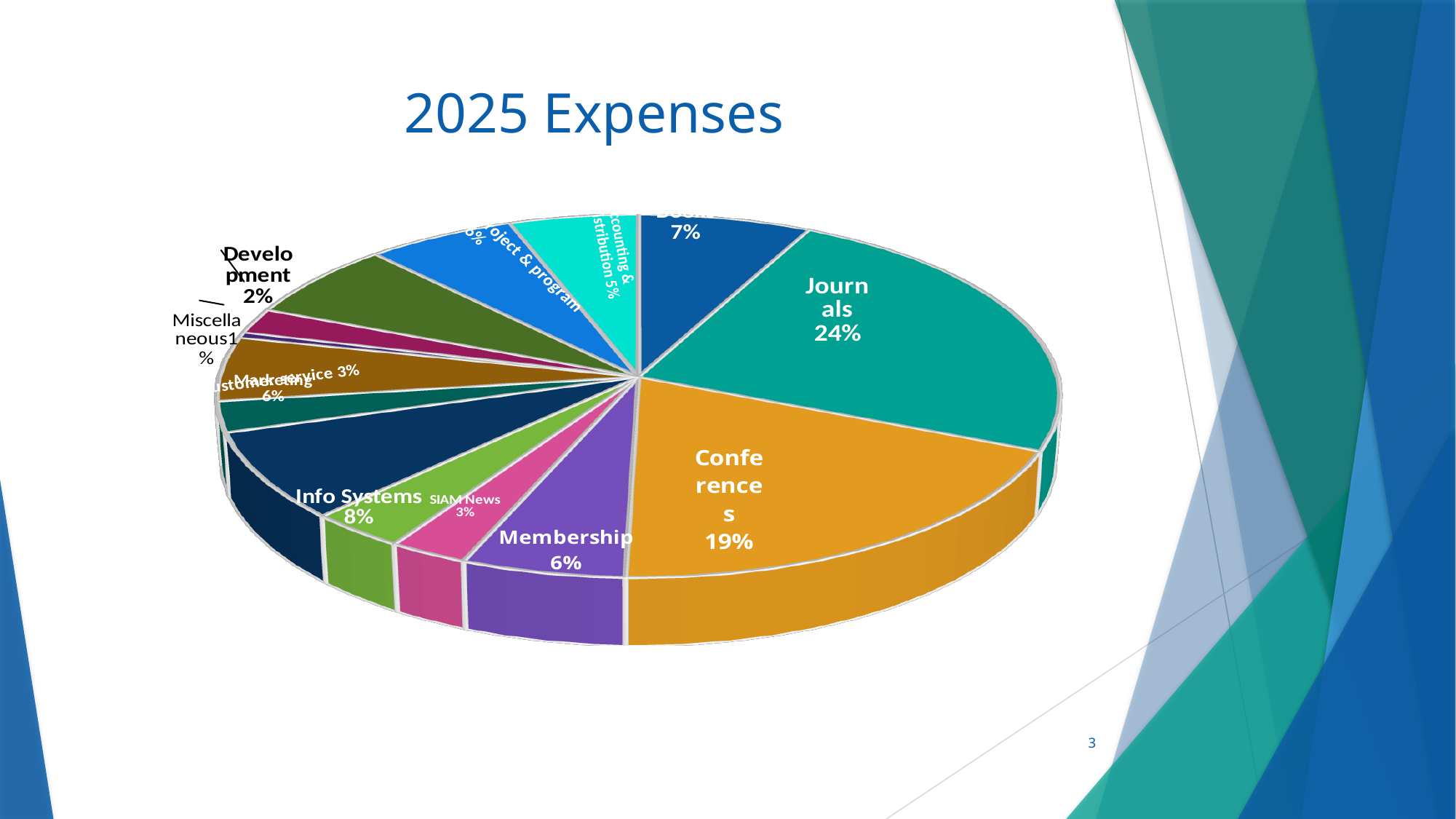
What share of 2025 expenses is Membership? 6% What is the title of the chart? 2025 Expenses What kind of chart is shown on the slide? pie chart How many percentage points larger is the Journals share than the Conferences share? 5 percentage points What share of 2025 expenses is Journals? 24% What share of 2025 expenses is Info Systems? 8% Which is larger, the share for Journals or the share for Conferences? Journals What share of 2025 expenses is Accounting & distribution? 5% What share of 2025 expenses is SIAM News? 3% What share of 2025 expenses is Development? 2% Which category has the largest share of 2025 expenses? Journals What share of 2025 expenses is Conferences? 19%